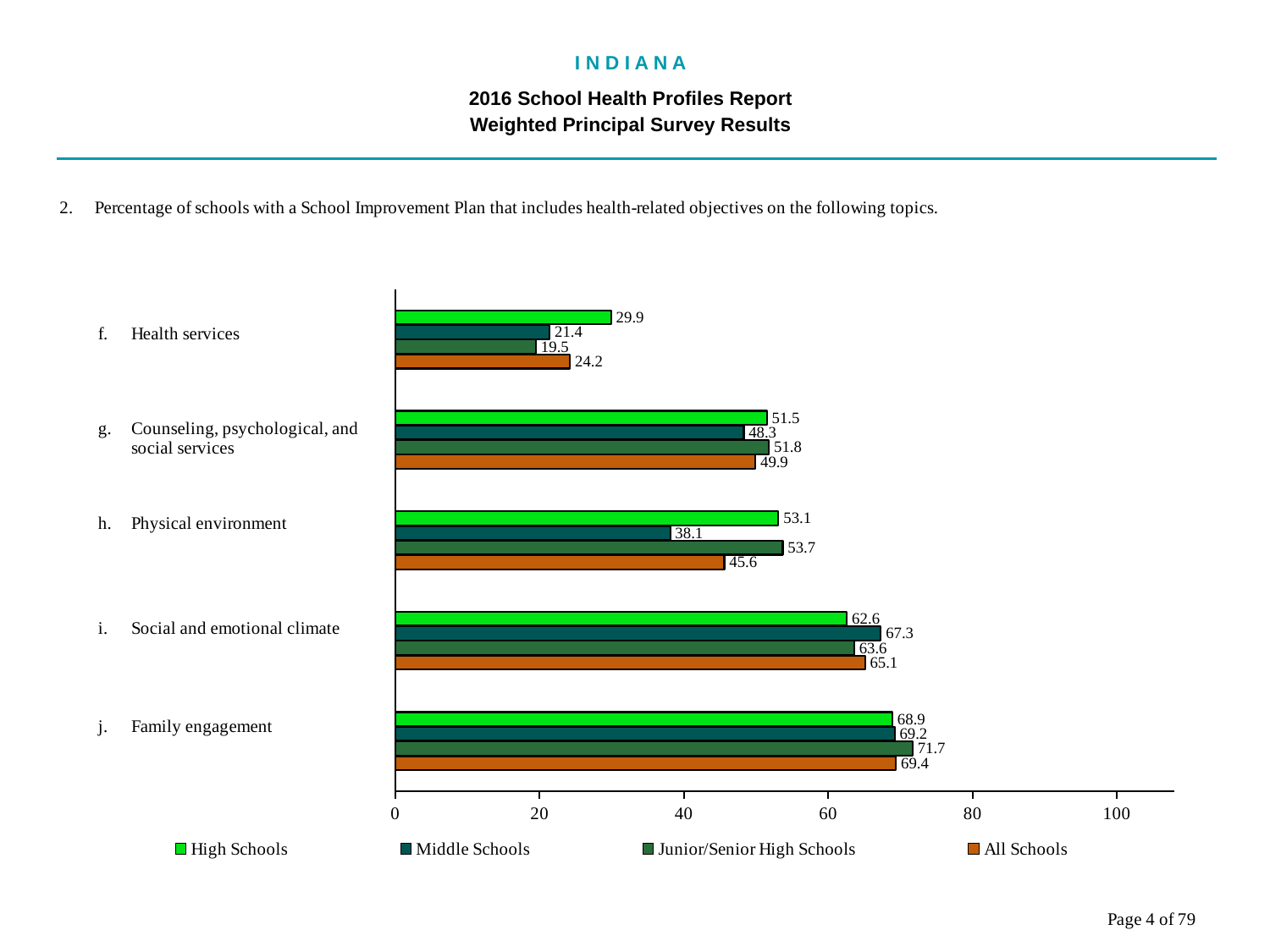
How many series does the legend list? 4 What is the value for Middle Schools for Physical environment? 38.1 Which topic has the lowest value for Middle Schools? Health services What is the value for All Schools for Family engagement? 69.4 What is the value for High Schools for Health services? 29.9 Which is larger for Social and emotional climate: the Middle Schools value or the High Schools value? Middle Schools What is the value for Junior/Senior High Schools for Counseling, psychological, and social services? 51.8 Which topic has the highest value for All Schools? Family engagement What is the difference between the High Schools and Middle Schools values for Physical environment? 15.0 What kind of chart is shown on the slide? Bar chart How many topics are shown on the chart? 5 Which series is shown in orange in the legend? All Schools